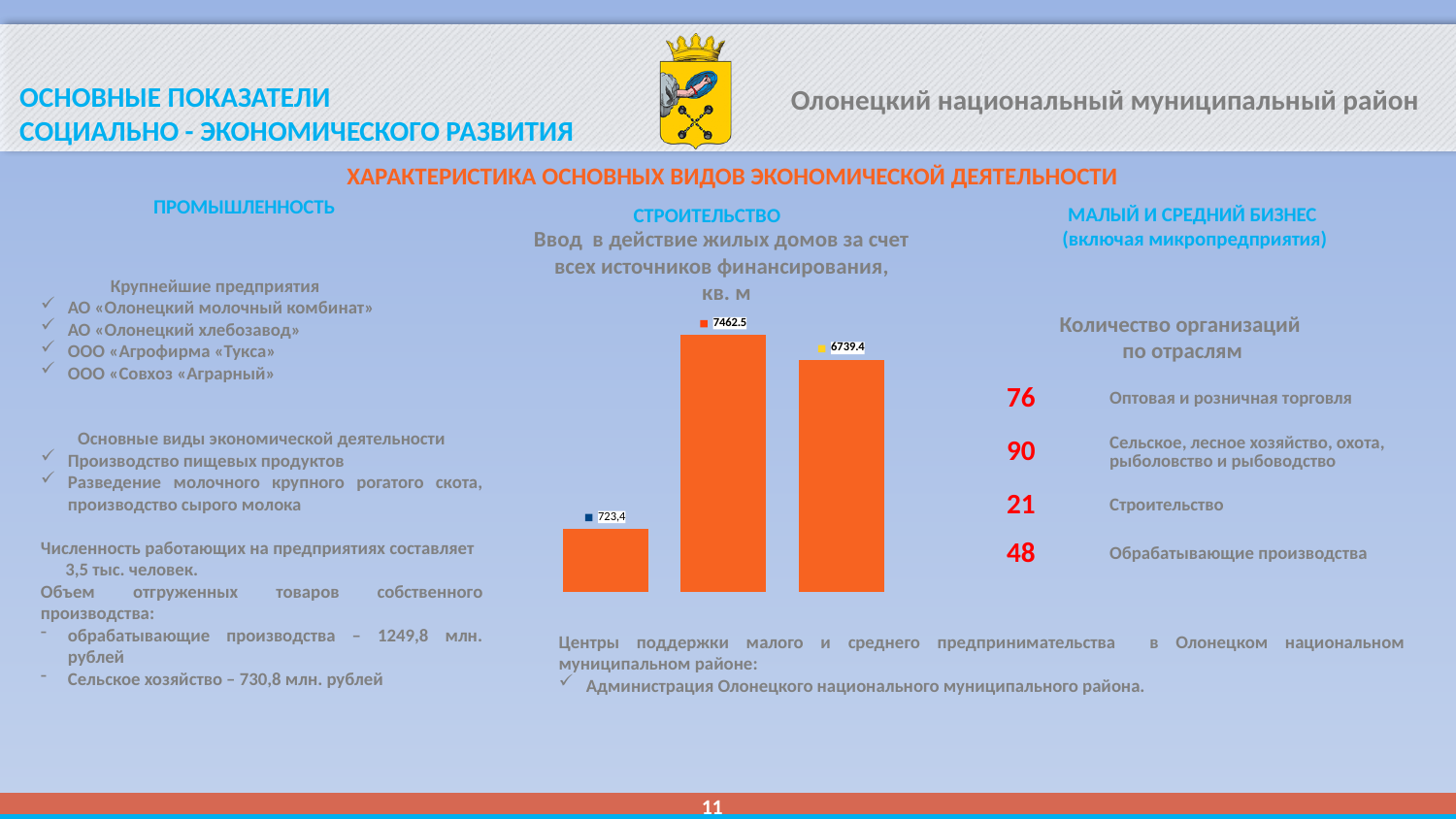
What unit of measurement is stated in the title of the chart under «СТРОИТЕЛЬСТВО»? кв. м In the chart «Ввод в действие жилых домов», is the middle bar or the right bar larger? the middle bar What type of chart is shown under the heading «СТРОИТЕЛЬСТВО»? bar chart What is the difference between the right bar (6739.4) and the left bar (723,4) in the chart «Ввод в действие жилых домов»? 6016 What value is printed on the left bar of the chart «Ввод в действие жилых домов»? 723,4 How many bars does the chart «Ввод в действие жилых домов за счет всех источников финансирования, кв. м» contain? 3 What colour are the bars in the chart «Ввод в действие жилых домов»? orange What is the difference between the middle bar (7462.5) and the right bar (6739.4) in the chart «Ввод в действие жилых домов»? 723.1 Which bar in the chart «Ввод в действие жилых домов» has the highest value? the middle bar (7462.5) What value is printed on the middle bar of the chart «Ввод в действие жилых домов»? 7462.5 What value is printed on the right bar of the chart «Ввод в действие жилых домов»? 6739.4 Which bar in the chart «Ввод в действие жилых домов» has the lowest value? the left bar (723,4)